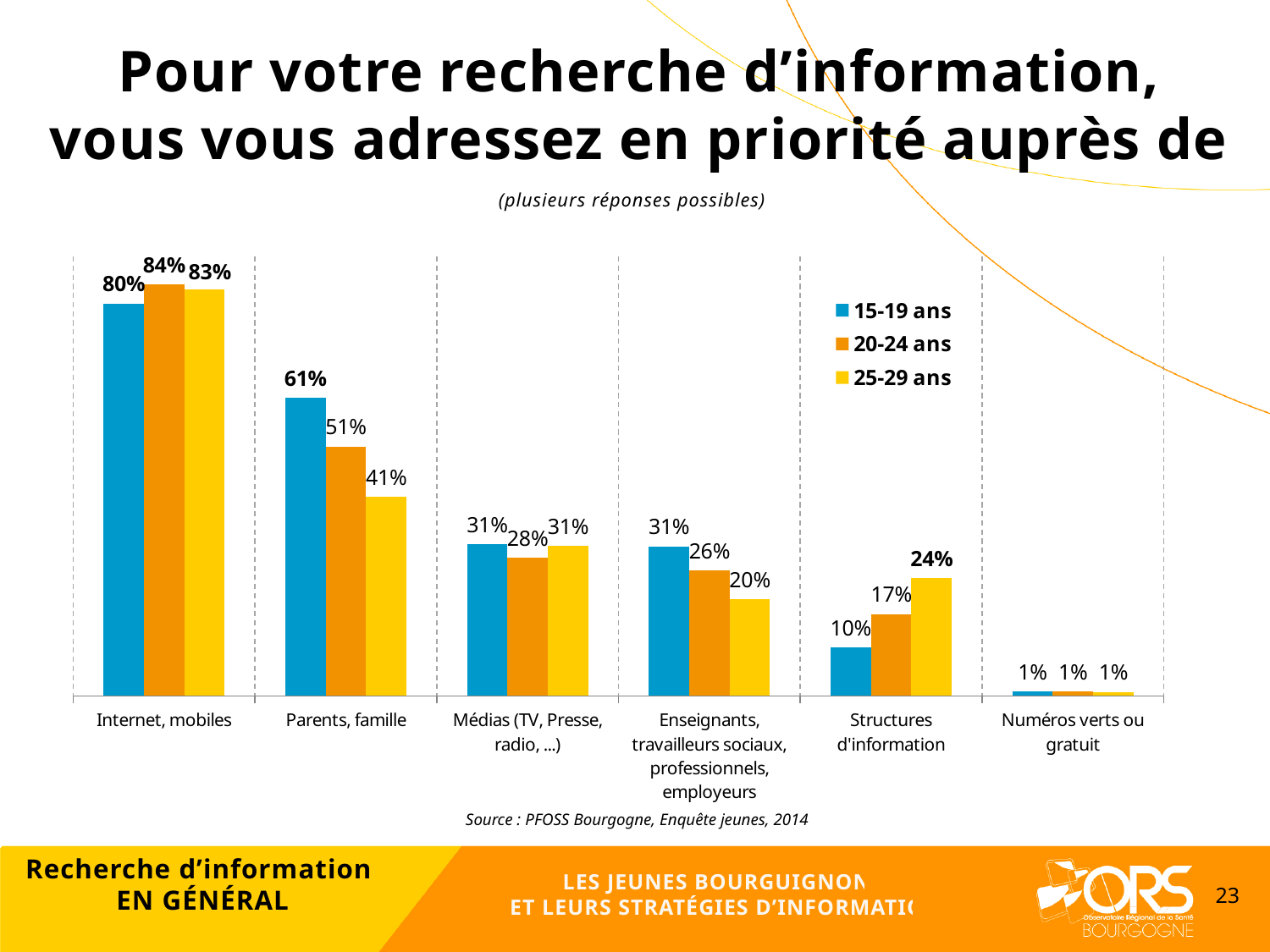
Which category has the highest value for the 20-24 ans series? Internet, mobiles What kind of chart is shown on the slide? Bar chart Do the values for the 15-19 ans series rise or fall from left to right across the categories? Fall What is the value for 25-29 ans in the Parents, famille category? 41% Which category has the lowest value for the 25-29 ans series? Numéros verts ou gratuit What is the difference between the 15-19 ans and 25-29 ans values in the Parents, famille category? 20% How many categories are shown on the x axis? 6 How many series does the legend list? 3 Which series is shown in yellow in the legend? 25-29 ans What is the value for 15-19 ans in the Internet, mobiles category? 80% In the Enseignants, travailleurs sociaux, professionnels, employeurs category, which is larger: the value for 15-19 ans or for 25-29 ans? 15-19 ans What is the value for 20-24 ans in the Structures d'information category? 17%